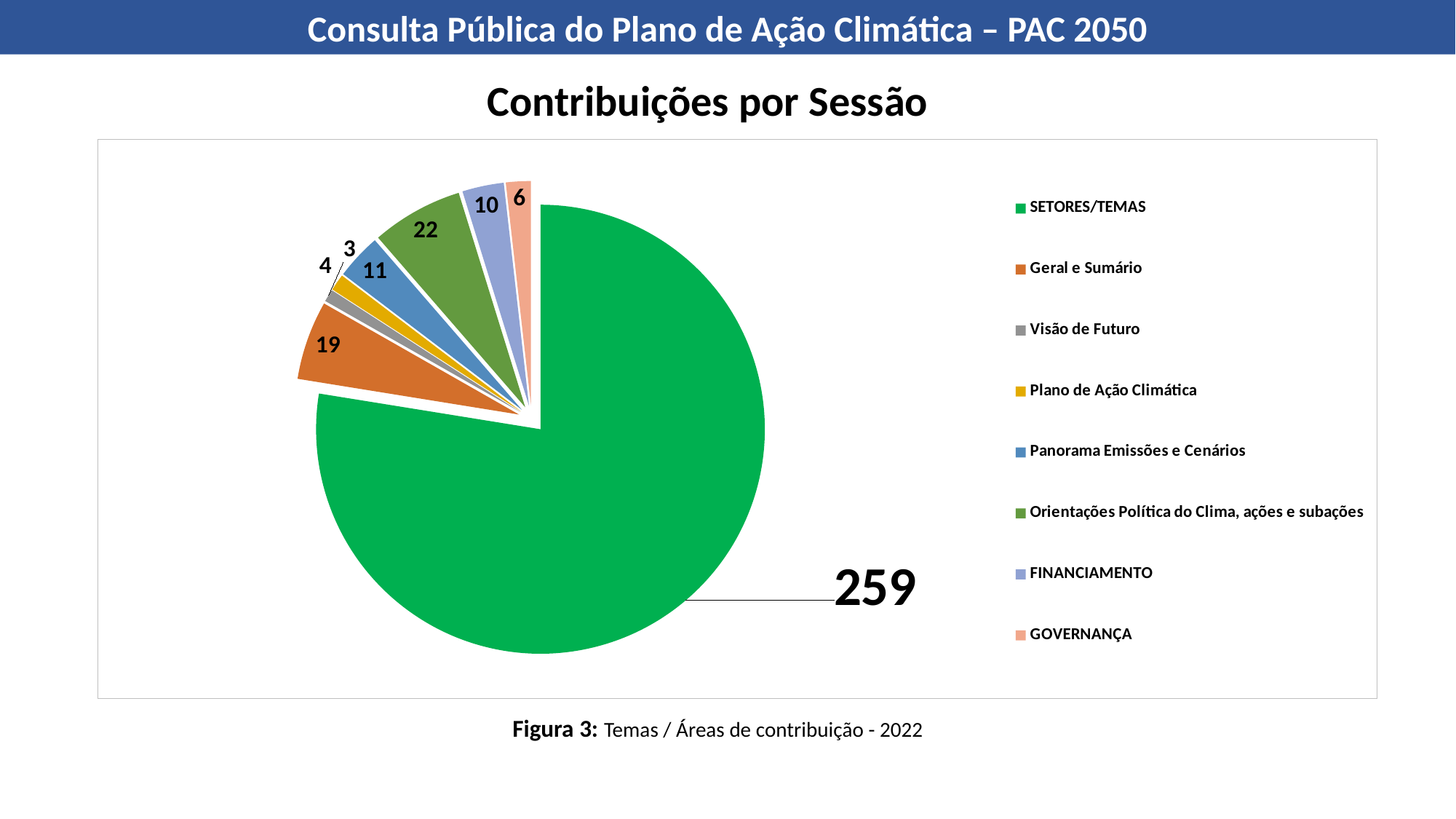
How many contributions are shown for SETORES/TEMAS? 259 What is the value for Orientações Política do Clima, ações e subações? 22 What is the value for FINANCIAMENTO? 10 Which category has the smallest slice of the pie? Visão de Futuro What is the total of all the slices in the pie? 334 What type of chart is shown on the slide? Pie chart Which is larger, the value for GOVERNANÇA or the value for Visão de Futuro? GOVERNANÇA What is the difference between the values for Orientações Política do Clima, ações e subações and Panorama Emissões e Cenários? 11 Which category has the largest slice of the pie? SETORES/TEMAS What is the value for Geral e Sumário? 19 What is the title of the chart? Contribuições por Sessão How many categories does the legend list? 8